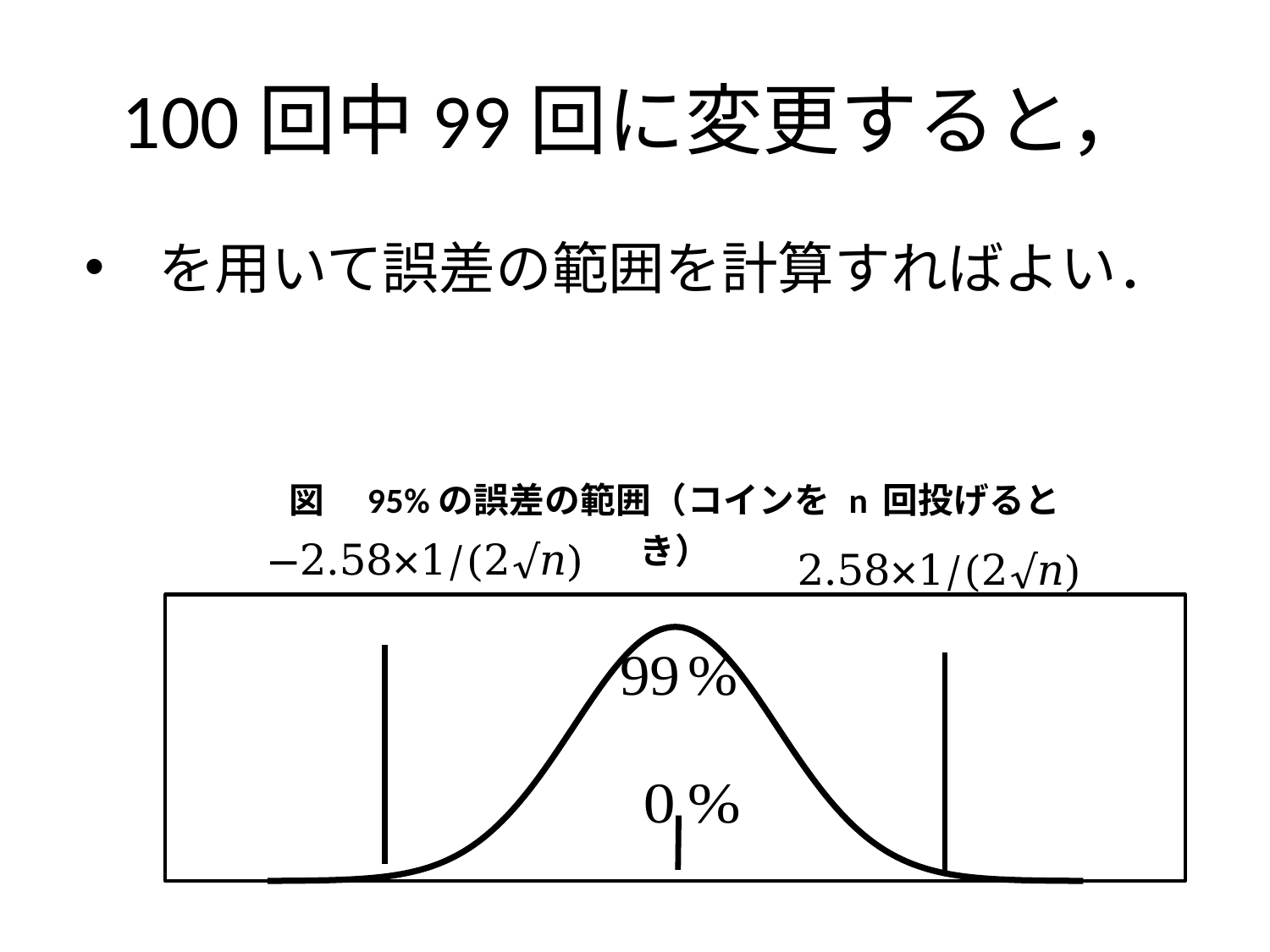
What percentage is printed under the peak of the curve in the figure? 99% What is the title of the figure on the slide? 図 95% の誤差の範囲（コインを n 回投げるとき） What value is printed at the centre of the horizontal axis in the figure? 0% What expression labels the left vertical boundary line in the figure? −2.58×1/(2√n) How many vertical boundary lines are drawn inside the curve's box in the figure (excluding the centre tick)? 2 What kind of curve is drawn in the figure at the bottom of the slide? A bell-shaped (normal distribution) curve Is the curve in the figure symmetric about the centre mark labelled 0%? Yes What expression labels the right vertical boundary line in the figure? 2.58×1/(2√n)